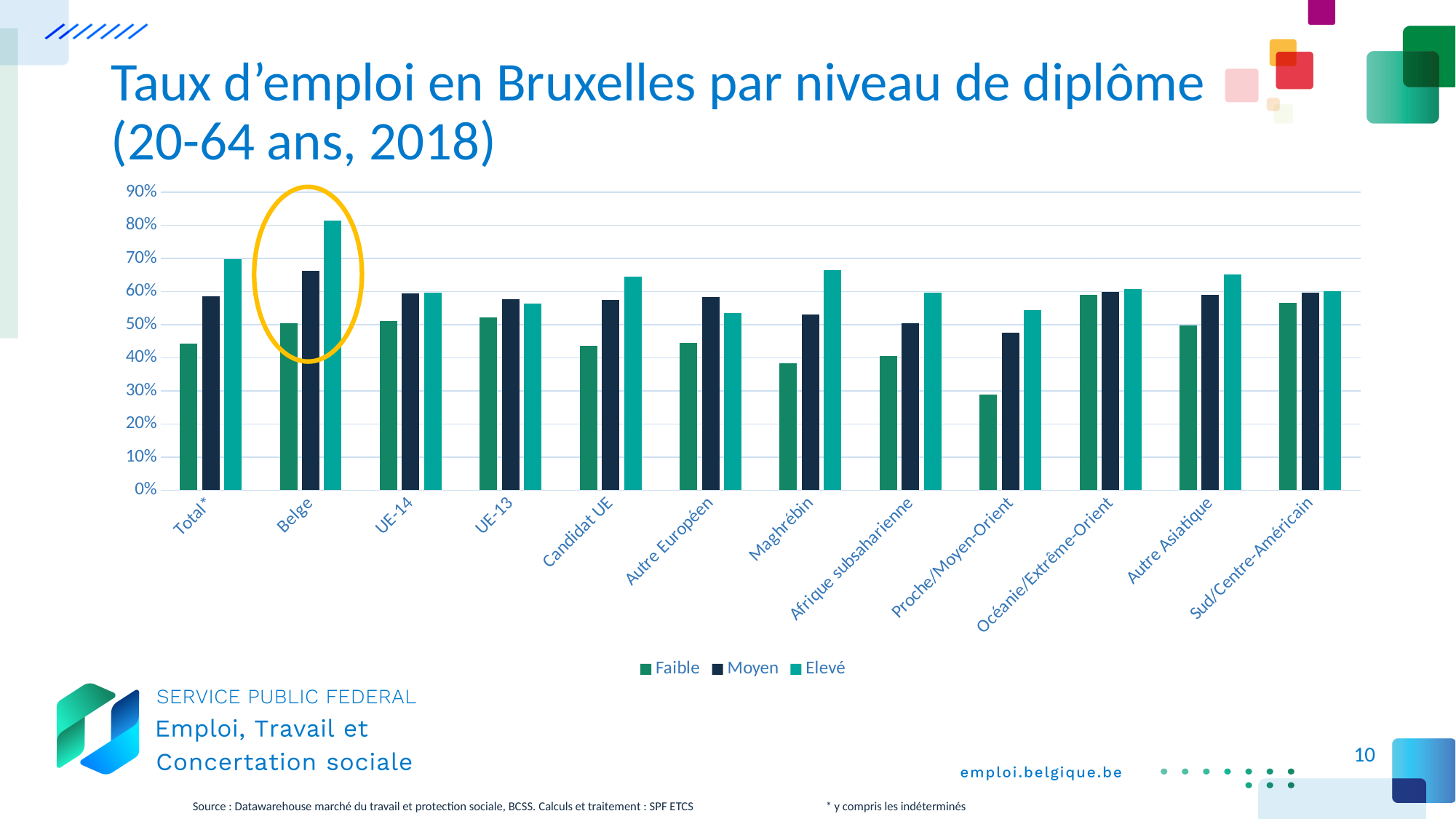
Is the Elevé value for Total* greater or less than 60%? greater What kind of chart is shown on the slide? bar chart Which category is highlighted with an orange circle on the chart? Belge For Autre Européen, which is larger, the Moyen value or the Elevé value? Moyen Which is larger, the Faible value for Maghrébin or the Faible value for Proche/Moyen-Orient? Maghrébin Is the Elevé value for Belge greater or less than 70%? greater Which category has the lowest value for the Faible series? Proche/Moyen-Orient Which category has the highest value for the Elevé series? Belge Is the Moyen value for Belge greater or less than 60%? greater How many series does the legend list? 3 How many categories are shown along the x axis? 12